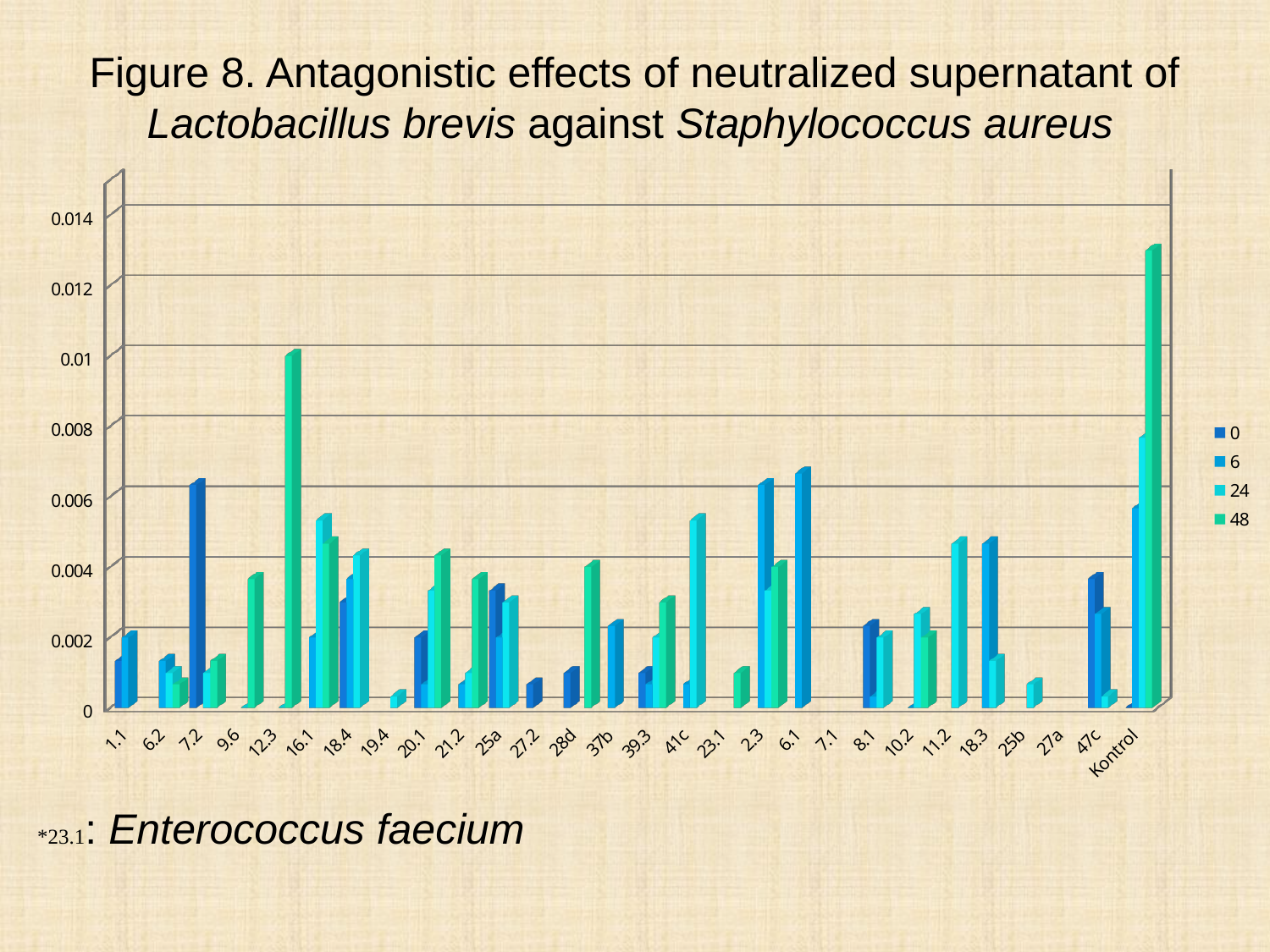
Is the value of the 48 series for Kontrol greater or less than 0.012? greater Is the value of the 48 series for 12.3 greater or less than 0.008? greater How many series does the legend list? 4 Which category has the tallest bar in the chart? Kontrol How many categories are shown along the x axis? 28 What are the series names listed in the legend? 0, 6, 24, 48 Is the value of the 48 series for 9.6 greater or less than 0.006? less What is the label of the last category on the x axis? Kontrol What kind of chart is shown on the slide? bar chart Which is larger for category 12.3: the 48 series bar or the 0 series bar? 48